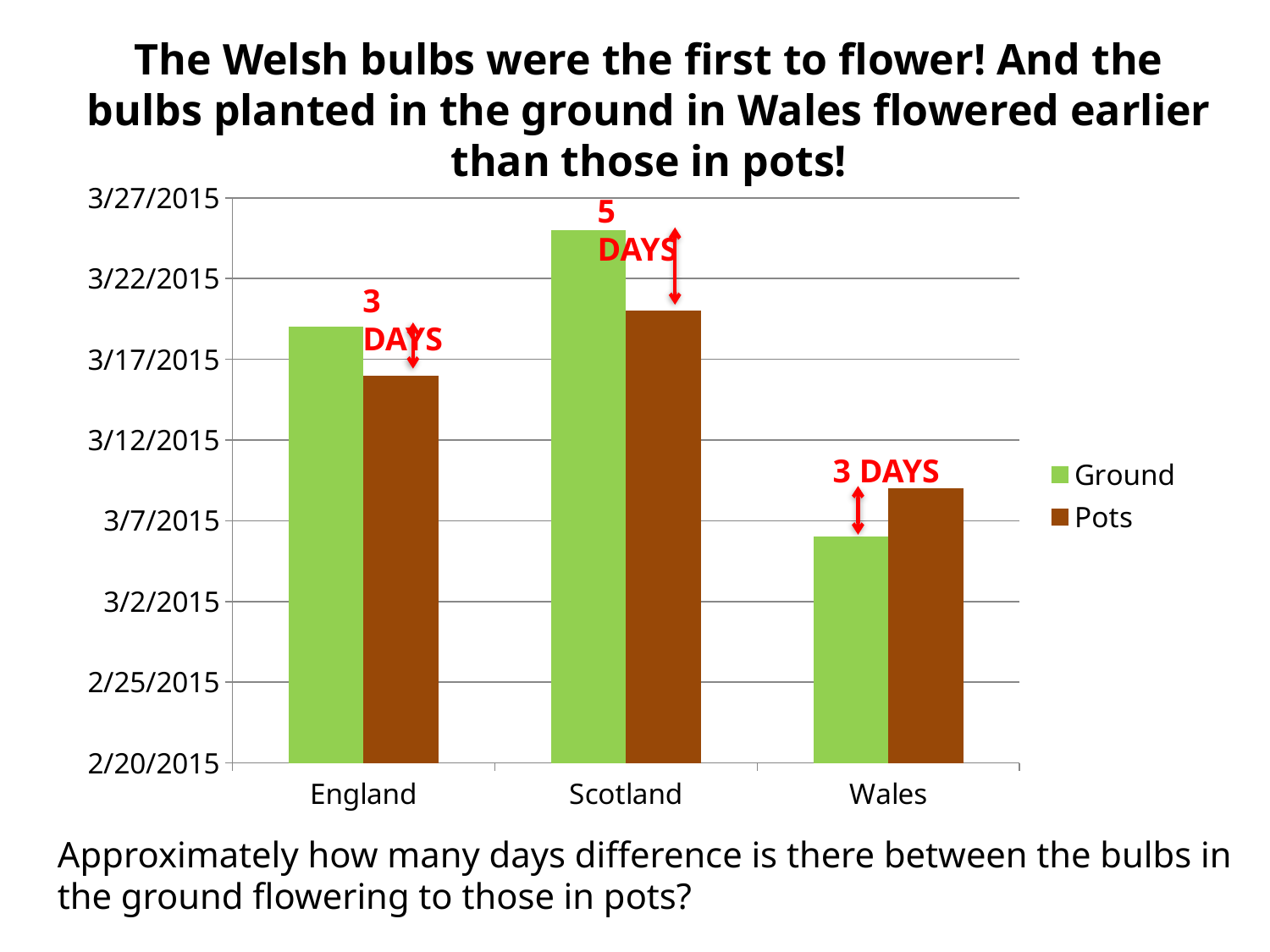
For England, which flowered earlier: the bulbs in the Ground or in Pots? Pots Which colour represents the Pots series in the chart? brown For Wales, which flowered earlier: the bulbs in the Ground or in Pots? Ground Is the Ground flowering date for Scotland later or earlier than 3/22/2015? later What are the two series named in the chart legend? Ground and Pots Which country has the earliest Pots flowering date in the chart? Wales How many countries are shown on the x axis of the chart? 3 What kind of chart is shown on the slide? bar chart Which country has the latest Ground flowering date in the chart? Scotland According to the label on the chart, how many days difference is there between Ground and Pots for Scotland? 5 DAYS Which country has the earliest Ground flowering date in the chart? Wales How many series does the chart legend list? 2